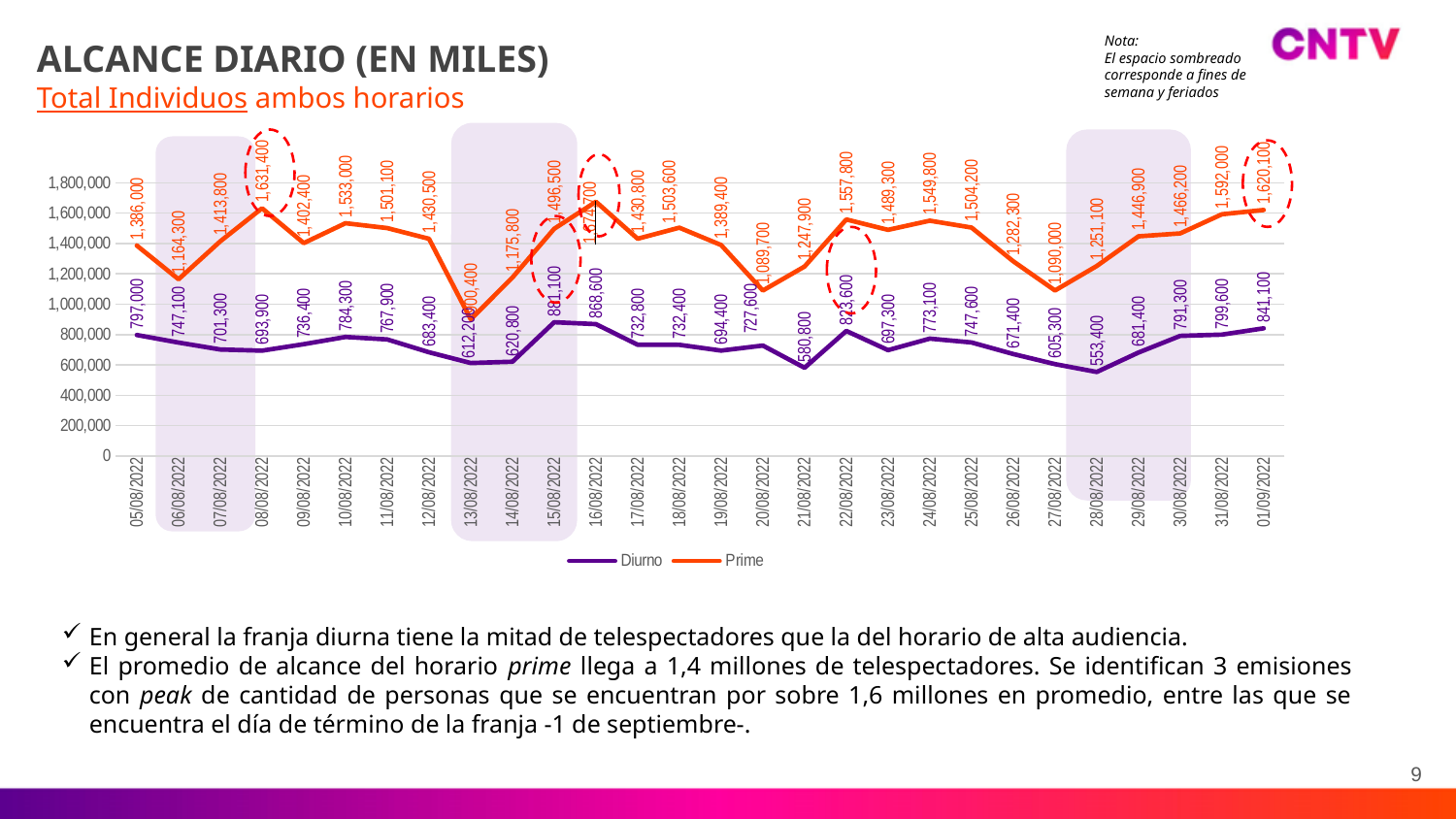
Which date has the higher Prime value, 31/08/2022 or 01/09/2022? 01/09/2022 What are the two series named in the legend? Diurno and Prime What is the Prime value for 08/08/2022? 1,631,400 What is the difference between the Prime and Diurno values on 01/09/2022? 779,000 How many series does the legend list? 2 On which date is the Prime series lowest? 13/08/2022 How many dates are plotted on the x axis? 28 On which date is the Diurno series lowest? 28/08/2022 What is the Diurno value for 21/08/2022? 580,800 Is the Prime value for 20/08/2022 greater or less than 1,200,000? less What is the Diurno value for 05/08/2022? 797,000 What kind of chart is shown on the slide? Line chart